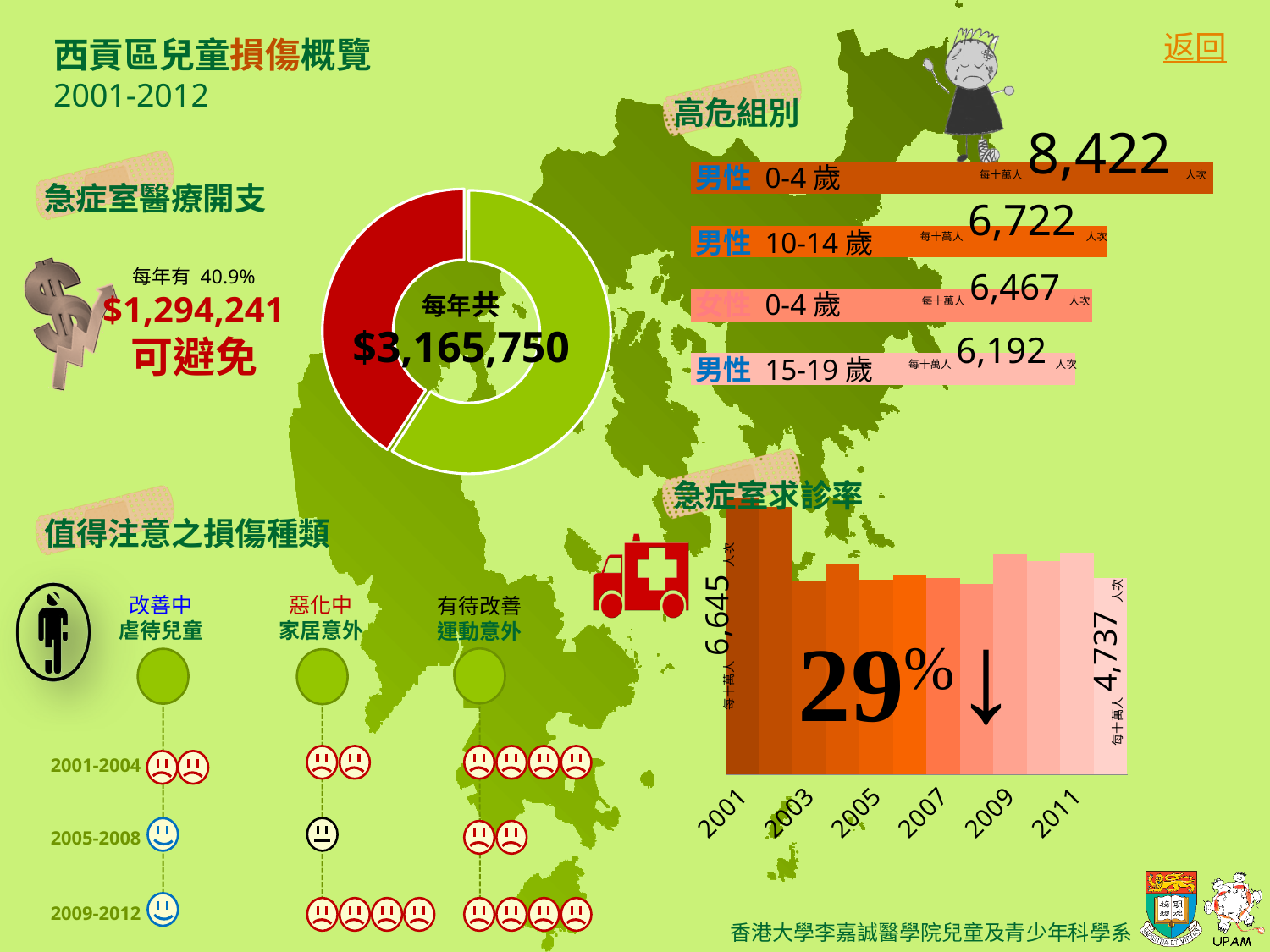
In the 高危組別 chart, which group has the lowest value? 男性 15-19 歲 In the 急症室求診率 chart, do the values generally rise or fall from 2001 to 2012? fall What kind of chart is the 高危組別 chart? bar chart In the 高危組別 chart, what is the difference between the values for 男性 0-4 歲 and 男性 10-14 歲? 1,700 In the 急症室求診率 chart, what is the value for 2001? 6,645 In the 高危組別 chart, which is larger: the value for 男性 10-14 歲 or 女性 0-4 歲? 男性 10-14 歲 In the 高危組別 chart, what is the value for 女性 0-4 歲? 6,467 In the 高危組別 chart, which group has the highest value? 男性 0-4 歲 In the 急症室求診率 chart, what is the value for the last year shown (2012)? 4,737 What is the total annual amount shown in the centre of the 急症室醫療開支 donut chart? $3,165,750 How many groups are shown in the 高危組別 chart? 4 In the 高危組別 chart, what is the value for 男性 0-4 歲? 8,422